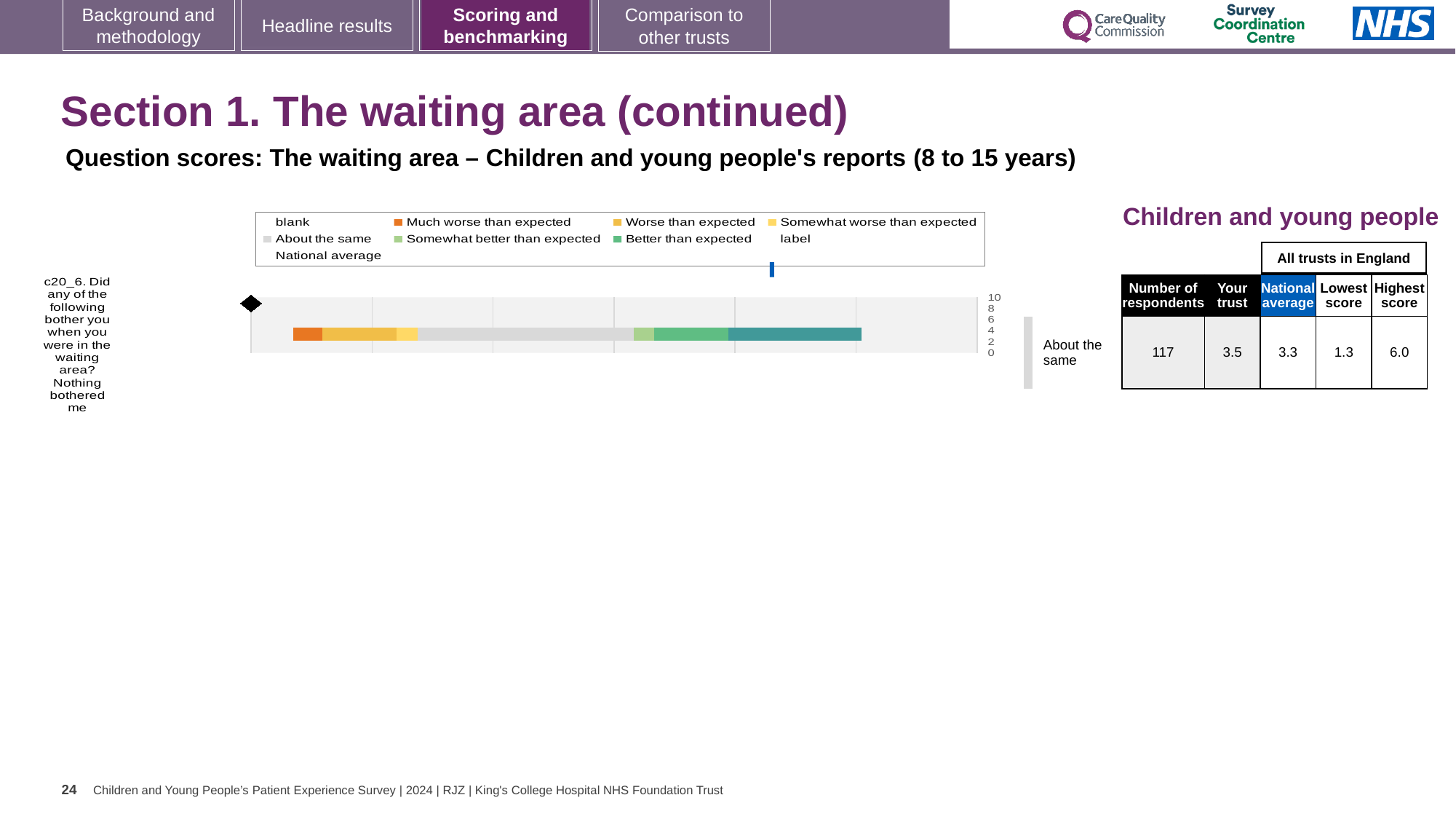
What is the difference between the 'Your trust' score and the national average for question c20_6? 0.2 How many entries does the chart legend list? 9 In the table beside the chart, what is the number of respondents for question c20_6? 117 What colour is the 'Much worse than expected' segment in the chart? orange In the table beside the chart, what is the highest score among all trusts in England? 6.0 What benchmark rating label is shown next to the bar for question c20_6? About the same In the table beside the chart, what is the lowest score among all trusts in England? 1.3 How many question categories are plotted in the chart? 1 Which is larger for question c20_6: the 'Your trust' score or the national average? Your trust What kind of chart is shown on the slide? bar chart In the table beside the chart, what is the 'Your trust' score for question c20_6? 3.5 In the table beside the chart, what is the national average score for question c20_6? 3.3